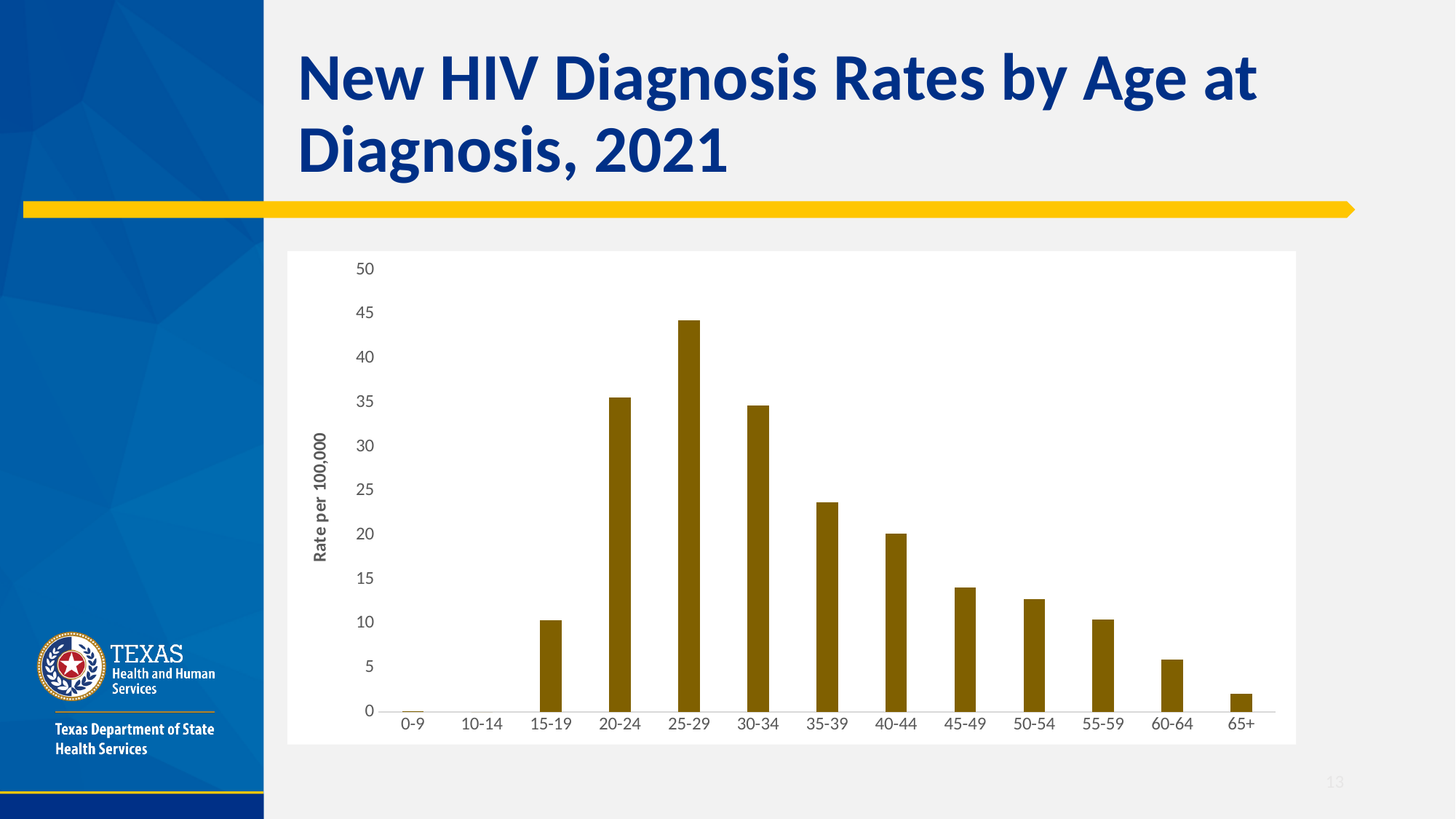
Which has the higher rate, the 45-49 age group or the 50-54 age group? 45-49 Is the value for the 60-64 age group greater or less than 5? greater Is the value for the 35-39 age group greater or less than 25? less Is the value for the 65+ age group greater or less than 5? less Which has the higher rate, the 35-39 age group or the 40-44 age group? 35-39 What kind of chart is shown on the slide? bar chart Do the values rise or fall across the age groups from 25-29 to 65+? fall What is the label on the y axis of the chart? Rate per 100,000 Which age group has the highest new HIV diagnosis rate? 25-29 How many age groups are shown on the x axis of the chart? 13